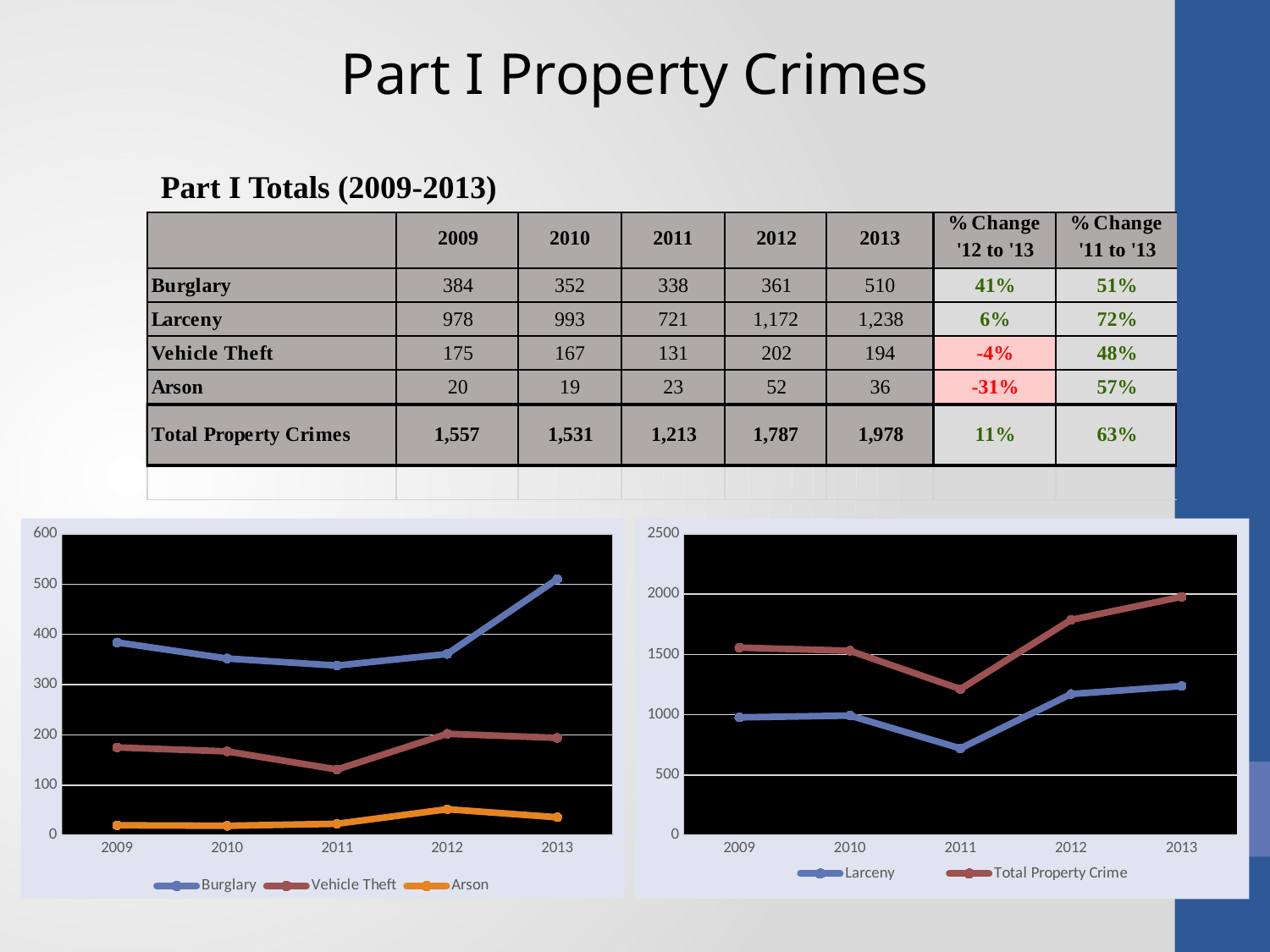
What kind of chart is the left chart on the slide? line chart In the right chart, does Total Property Crime rise or fall from 2011 to 2013? rise In the left chart, is the Vehicle Theft value for 2011 greater or less than 200? less How many series does the legend of the right chart list? 2 In the right chart, is Total Property Crime larger in 2009 or in 2013? 2013 In the left chart, which colour is used for the Arson series? orange In the right chart, in which year is Larceny lowest? 2011 In the left chart, is the Burglary value for 2013 greater or less than 400? greater How many years are plotted along the x axis of the right chart? 5 According to the slide, what is the Burglary value for 2013 plotted in the left chart? 510 How many series does the legend of the left chart list? 3 In the left chart, in which year is Burglary highest? 2013